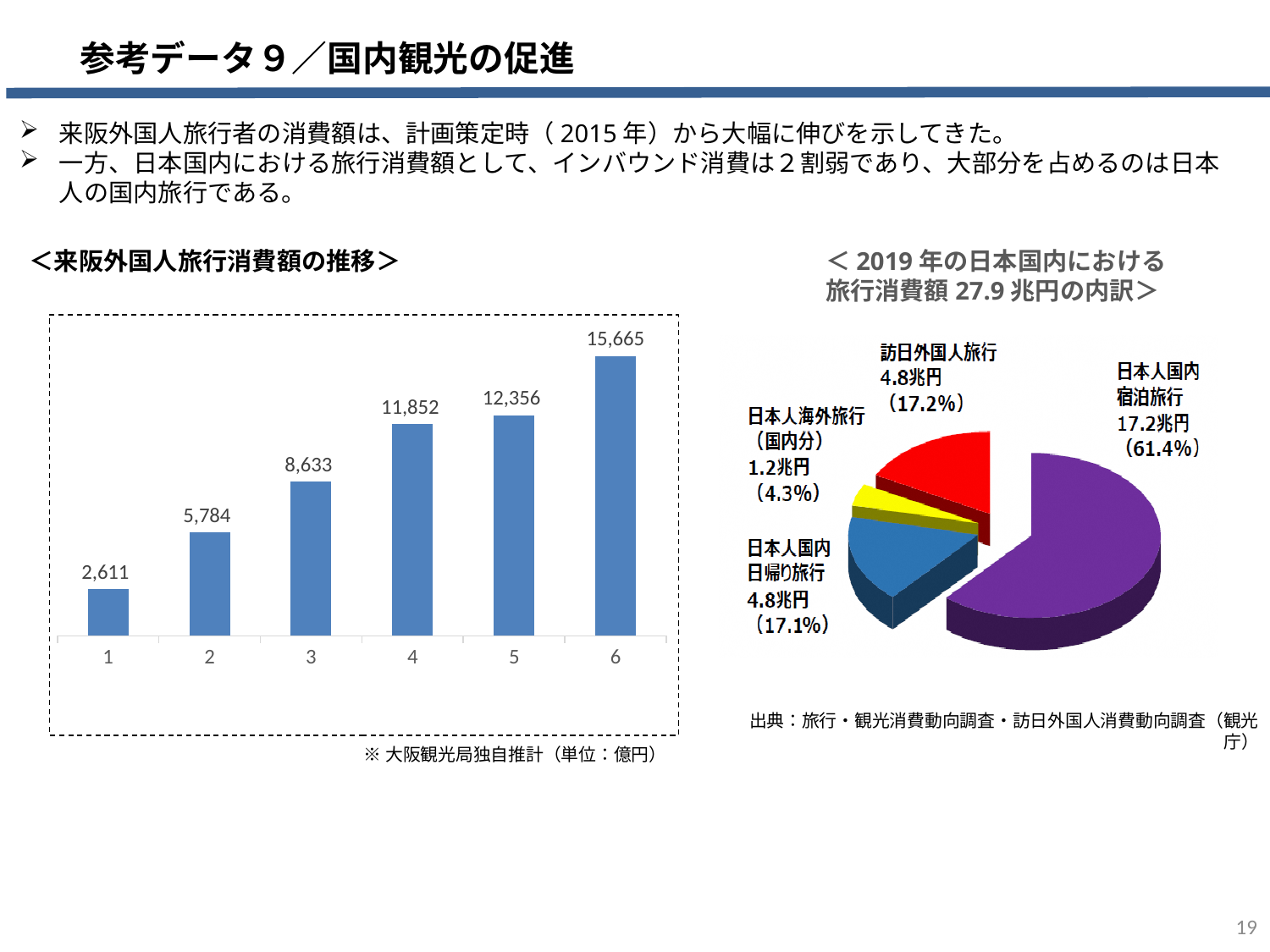
In the bar chart on the left (来阪外国人旅行消費額の推移), what is the value for category 4? 11,852 In the bar chart on the left (来阪外国人旅行消費額の推移), which category has the lowest value? 1 In the pie chart on the right (2019年の日本国内における旅行消費額27.9兆円の内訳), what share does 日本人国内宿泊旅行 have? 61.4% In the pie chart on the right (2019年の日本国内における旅行消費額27.9兆円の内訳), how many slices are there? 4 In the bar chart on the left (来阪外国人旅行消費額の推移), what is the difference between the values for category 6 and category 5? 3,309 What kind of chart is the chart on the left (来阪外国人旅行消費額の推移)? bar chart In the bar chart on the left (来阪外国人旅行消費額の推移), what is the value for category 1? 2,611 In the bar chart on the left (来阪外国人旅行消費額の推移), do the values rise or fall from category 1 to category 6? rise In the pie chart on the right (2019年の日本国内における旅行消費額27.9兆円の内訳), which slice is the smallest? 日本人海外旅行（国内分） In the bar chart on the left (来阪外国人旅行消費額の推移), how many bars are plotted? 6 In the pie chart on the right (2019年の日本国内における旅行消費額27.9兆円の内訳), what is the value for 日本人海外旅行（国内分）? 1.2兆円 In the bar chart on the left (来阪外国人旅行消費額の推移), which category has the highest value? 6